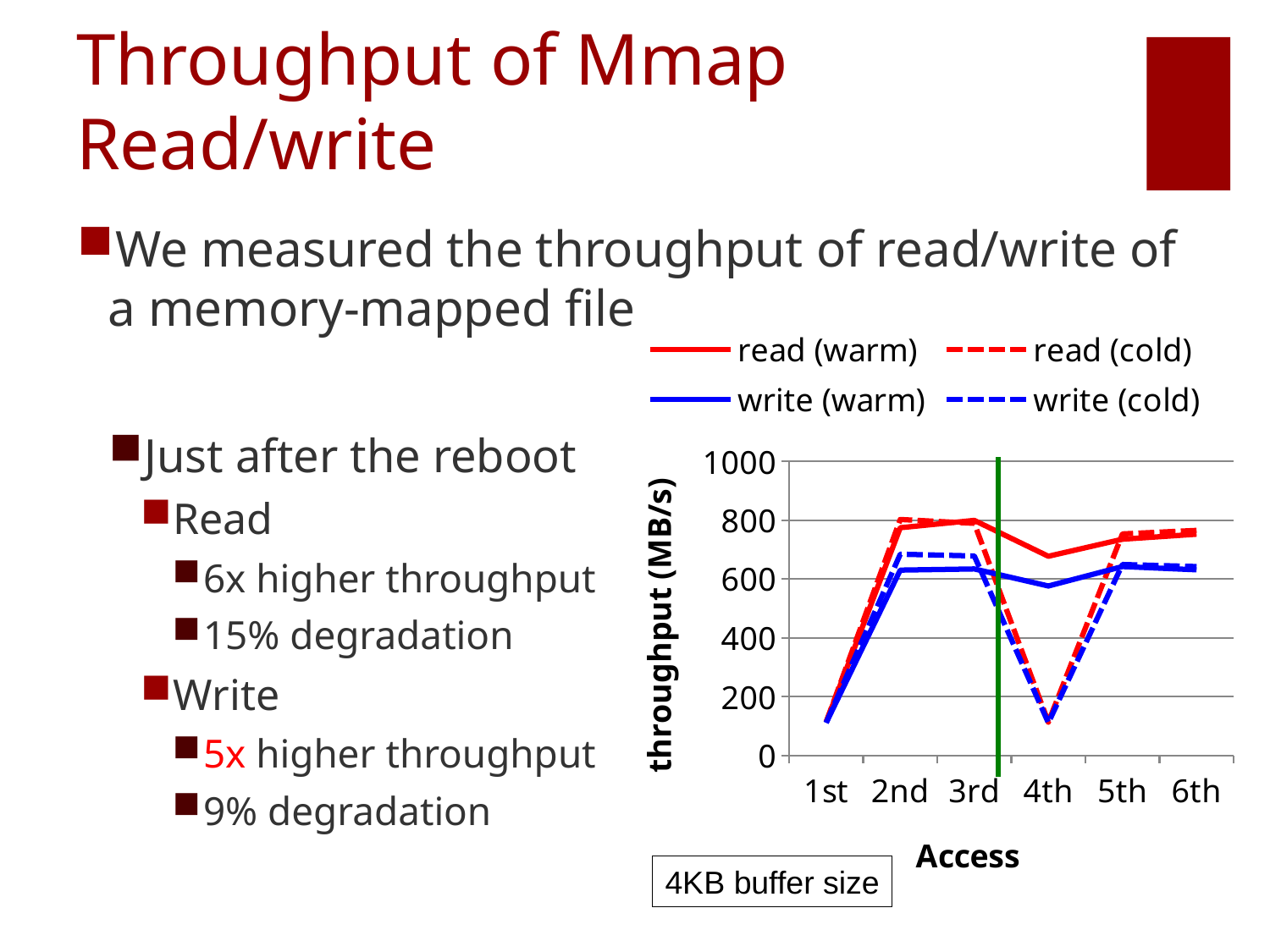
What is the title of the x axis? Access At the 4th access, which is larger: read (warm) or read (cold)? read (warm) Does the read (cold) series rise or fall from the 3rd access to the 4th access? fall How many access points are plotted along the x axis? 6 At the 2nd access, which is larger: read (warm) or write (warm)? read (warm) What is the title of the y axis? throughput (MB/s) Is the value for write (warm) at the 2nd access greater or less than 400? greater How many series does the chart's legend list? 4 What kind of chart is shown on the slide? line chart Is the value for read (cold) at the 4th access greater or less than 200? less Is the value for read (warm) at the 2nd access greater or less than 600? greater